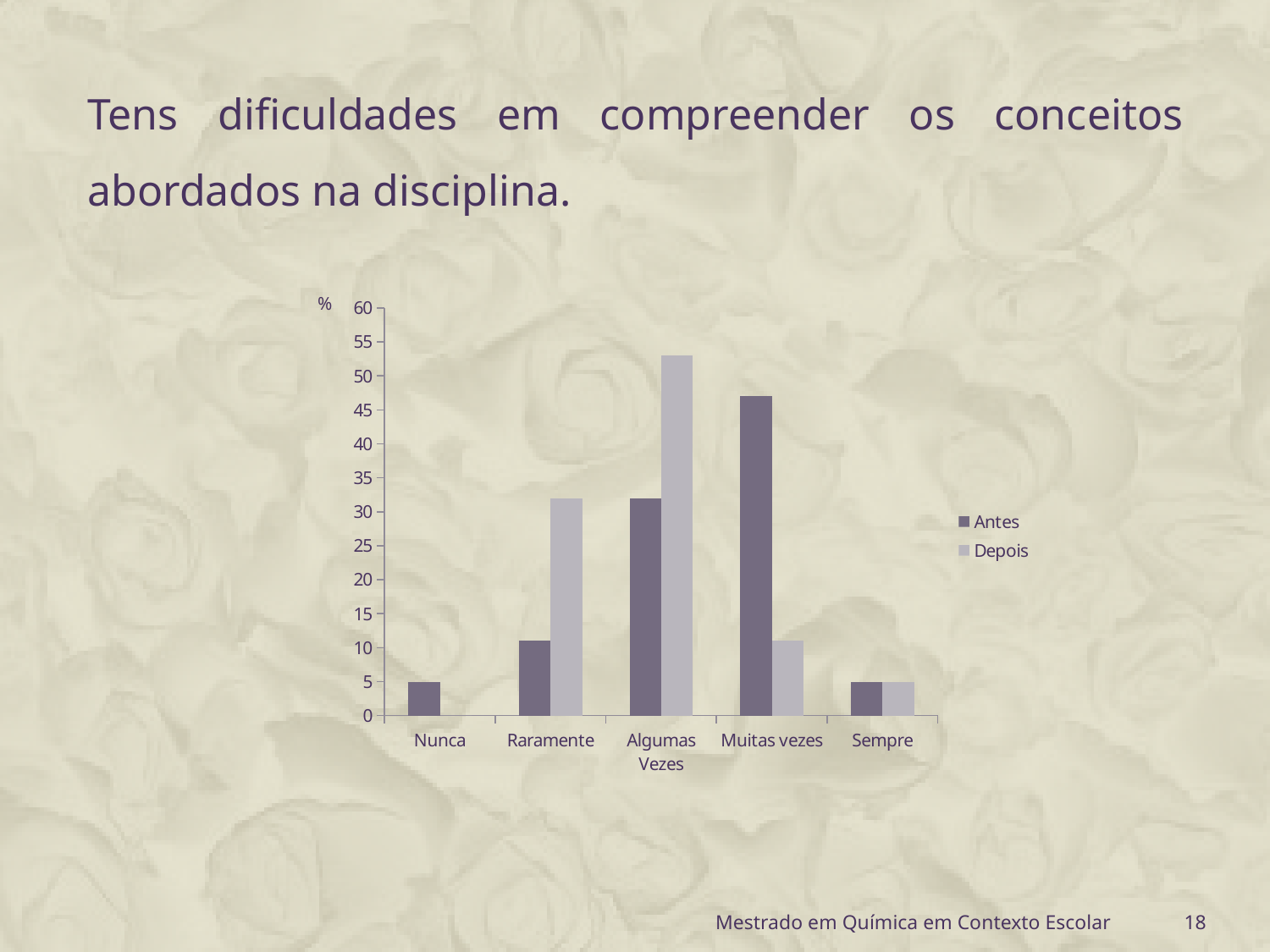
Is the Depois value for Algumas Vezes greater or less than 50? greater Which category has the highest Antes value? Muitas vezes How many series does the legend list? 2 In the Raramente category, which series has the larger value, Antes or Depois? Depois What kind of chart is shown on the slide? bar chart How many categories are shown on the x axis? 5 What is the value for Antes in the Nunca category? 5 What is the value for Depois in the Sempre category? 5 What are the two series named in the legend? Antes and Depois Is the Antes value for Raramente greater or less than 15? less In the Muitas vezes category, which series has the larger value, Antes or Depois? Antes Which category has the highest Depois value? Algumas Vezes